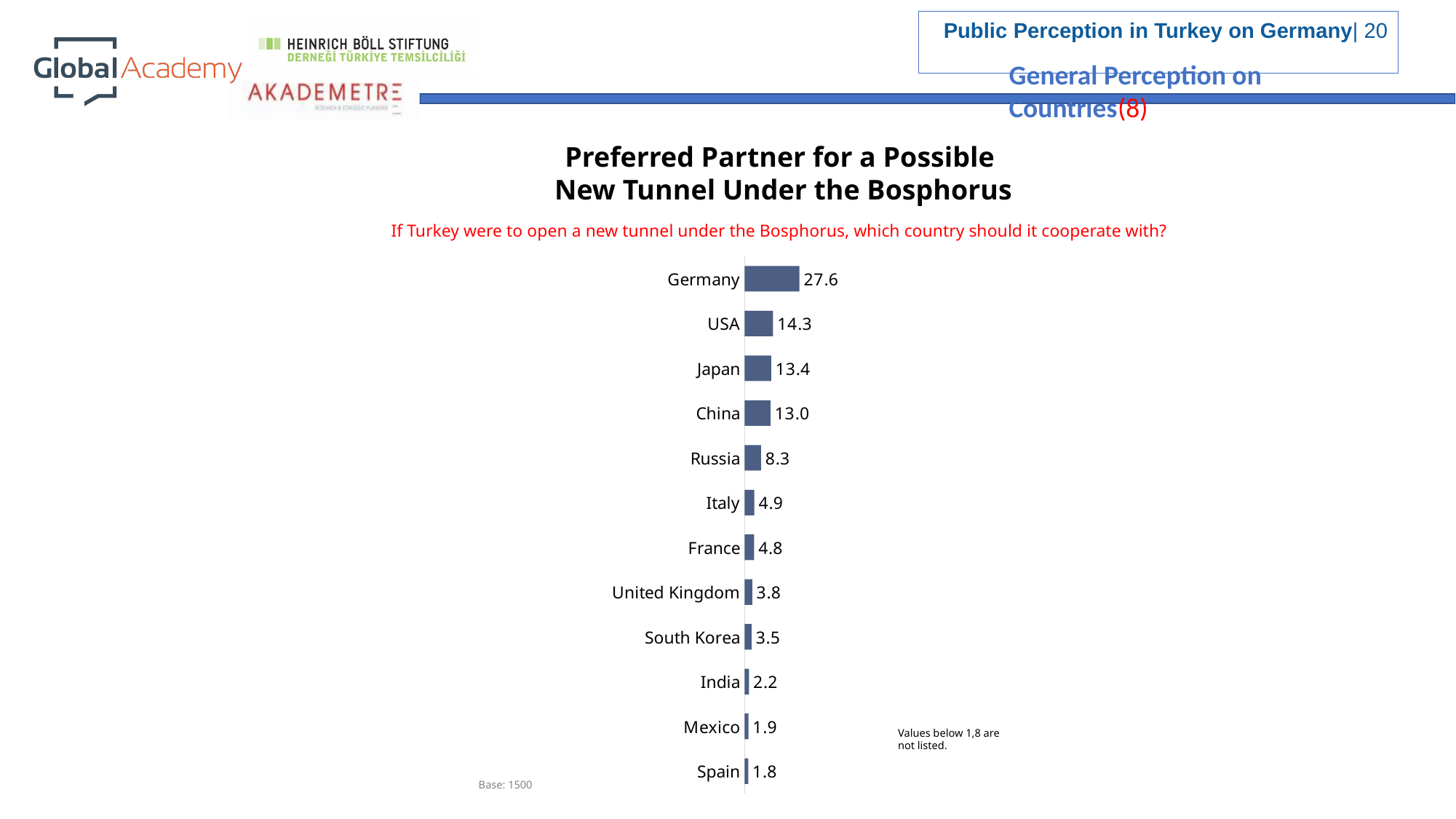
What is the value for Germany? 27.6 What kind of chart is shown? Bar chart What is the value for South Korea? 3.5 What is the difference between the values for Germany and USA? 13.3 Which is larger, the value for Russia or the value for Italy? Russia Which country has the lowest value shown? Spain What is the difference between the values for Japan and China? 0.4 Which country has the highest value? Germany What is the title of the chart? Preferred Partner for a Possible New Tunnel Under the Bosphorus What is the base (sample size) noted on the chart? 1500 How many countries are listed in the chart? 12 What is the value for Russia? 8.3